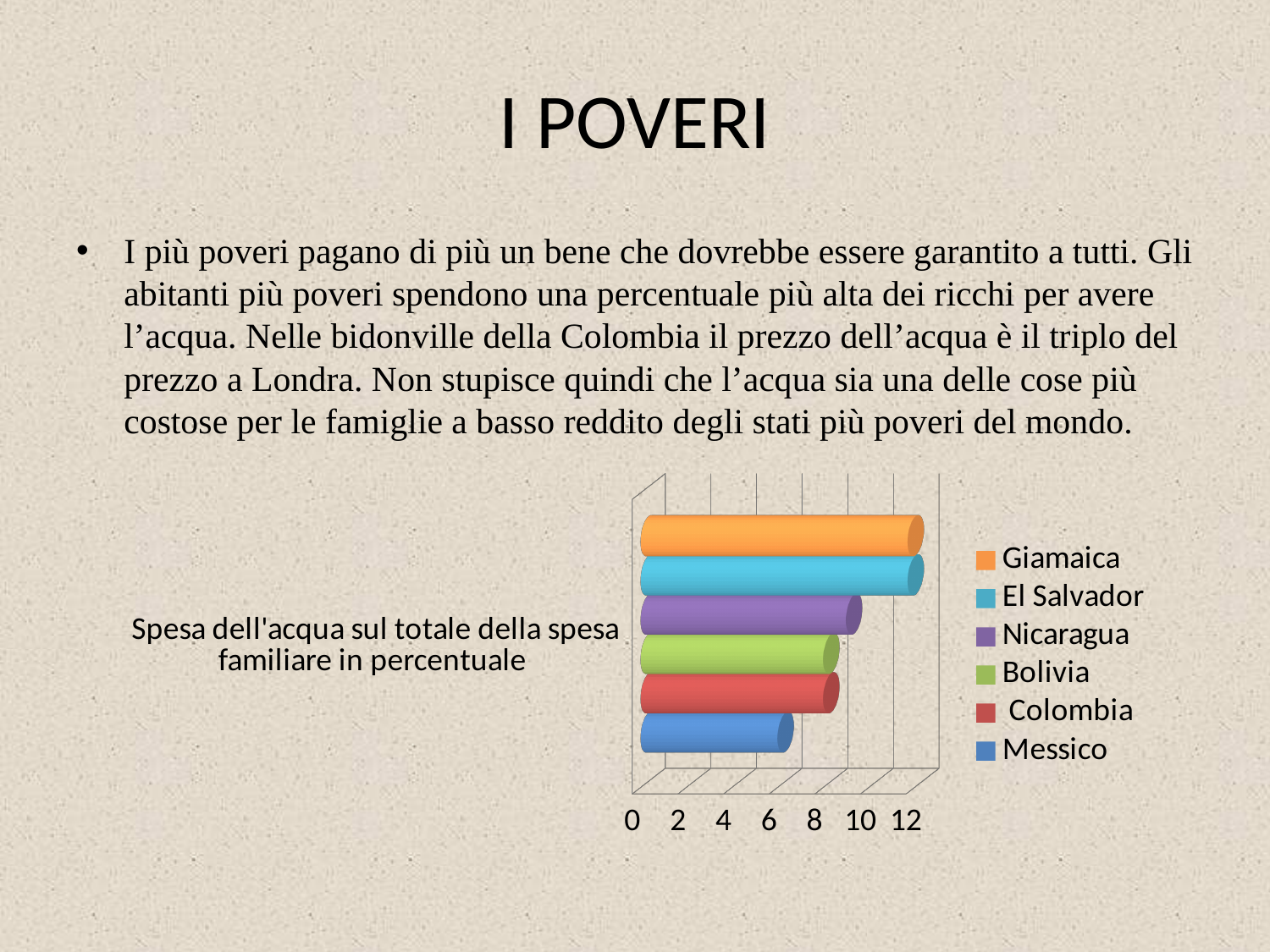
Which is larger, the value for Nicaragua or the value for Messico? Nicaragua Is the value for Nicaragua greater or less than 8? greater How many entries does the chart legend list? 6 Is the value for Messico greater or less than 8? less What kind of chart is shown on the slide? bar chart How many bars does the chart show? 6 Which is larger, the value for Giamaica or the value for Bolivia? Giamaica What is the title of the chart? Spesa dell'acqua sul totale della spesa familiare in percentuale What colour is the bar for Giamaica? orange Is the value for Giamaica greater or less than 10? greater Which country has the lowest value in the chart? Messico